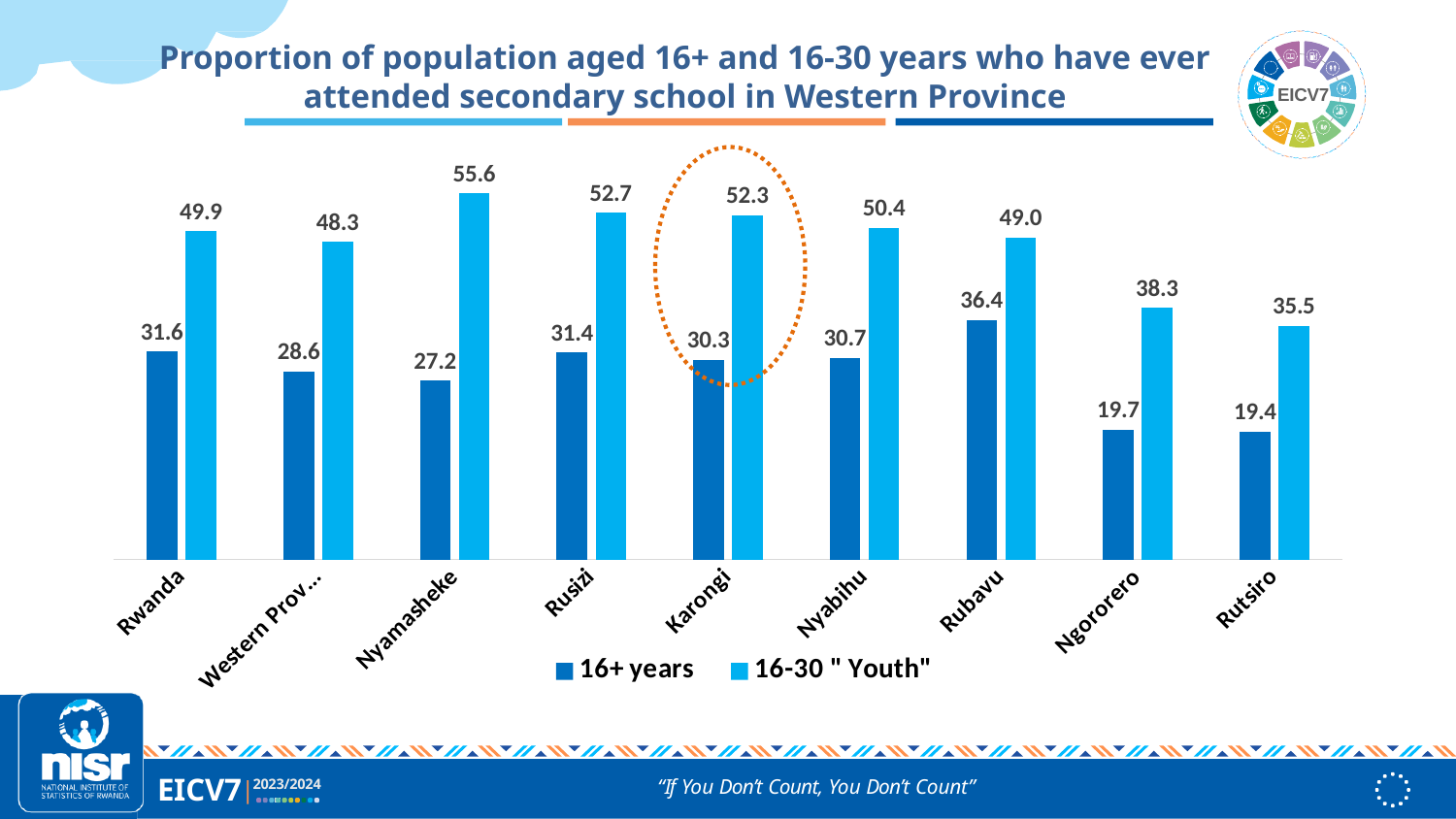
How many series does the legend list? 2 What is the difference between the 16-30 "Youth" values for Ngororero and Rutsiro? 2.8 Which district has the highest value for the 16-30 "Youth" series? Nyamasheke What is the value for the 16-30 "Youth" series in Nyamasheke? 55.6 What is the difference between the 16-30 "Youth" value and the 16+ years value in Rwanda? 18.3 Which category on the chart is highlighted with a dotted orange circle? Karongi Which is larger: the 16+ years value for Rubavu or for Nyabihu? Rubavu What is the value for the 16+ years series in Karongi? 30.3 What kind of chart is shown on the slide? Bar chart How many categories are shown on the x axis? 9 Which category has the lowest value for the 16+ years series? Rutsiro What is the value for the 16+ years series in Rubavu? 36.4